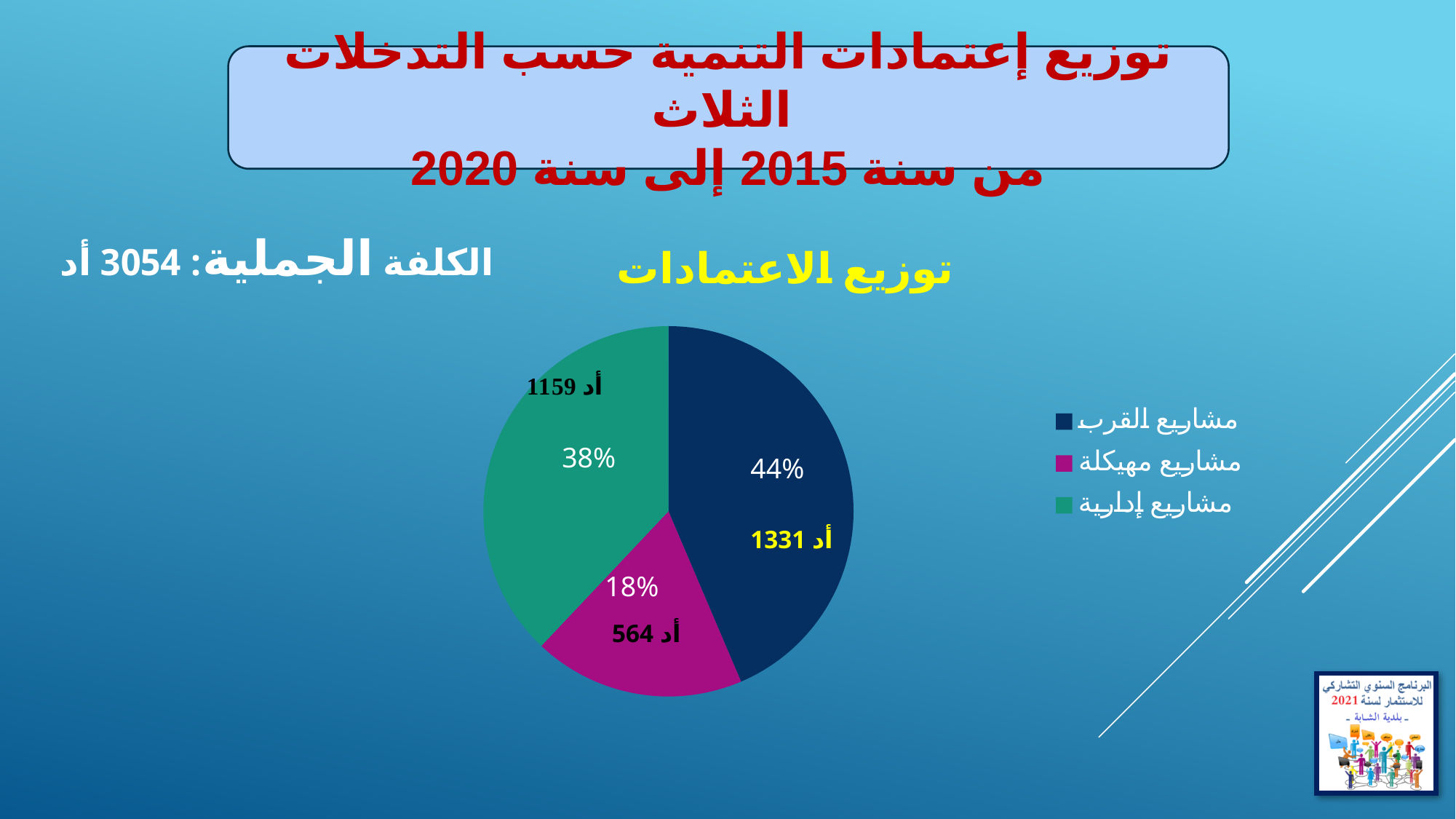
What share of the pie does مشاريع القرب represent? 44% What is the value shown for مشاريع مهيكلة? 564 أد What is the value shown for مشاريع إدارية? 1159 أد Which is larger, the value for مشاريع إدارية or the value for مشاريع مهيكلة? مشاريع إدارية What share of the pie does مشاريع إدارية represent? 38% Which category has the smallest slice of the pie? مشاريع مهيكلة Which category has the largest slice of the pie? مشاريع القرب What is the difference between the values for مشاريع القرب and مشاريع إدارية? 172 أد What kind of chart is shown on the slide? pie chart What colour is the slice for مشاريع مهيكلة? magenta What is the value shown for مشاريع القرب? 1331 أد How many categories does the pie chart show? 3